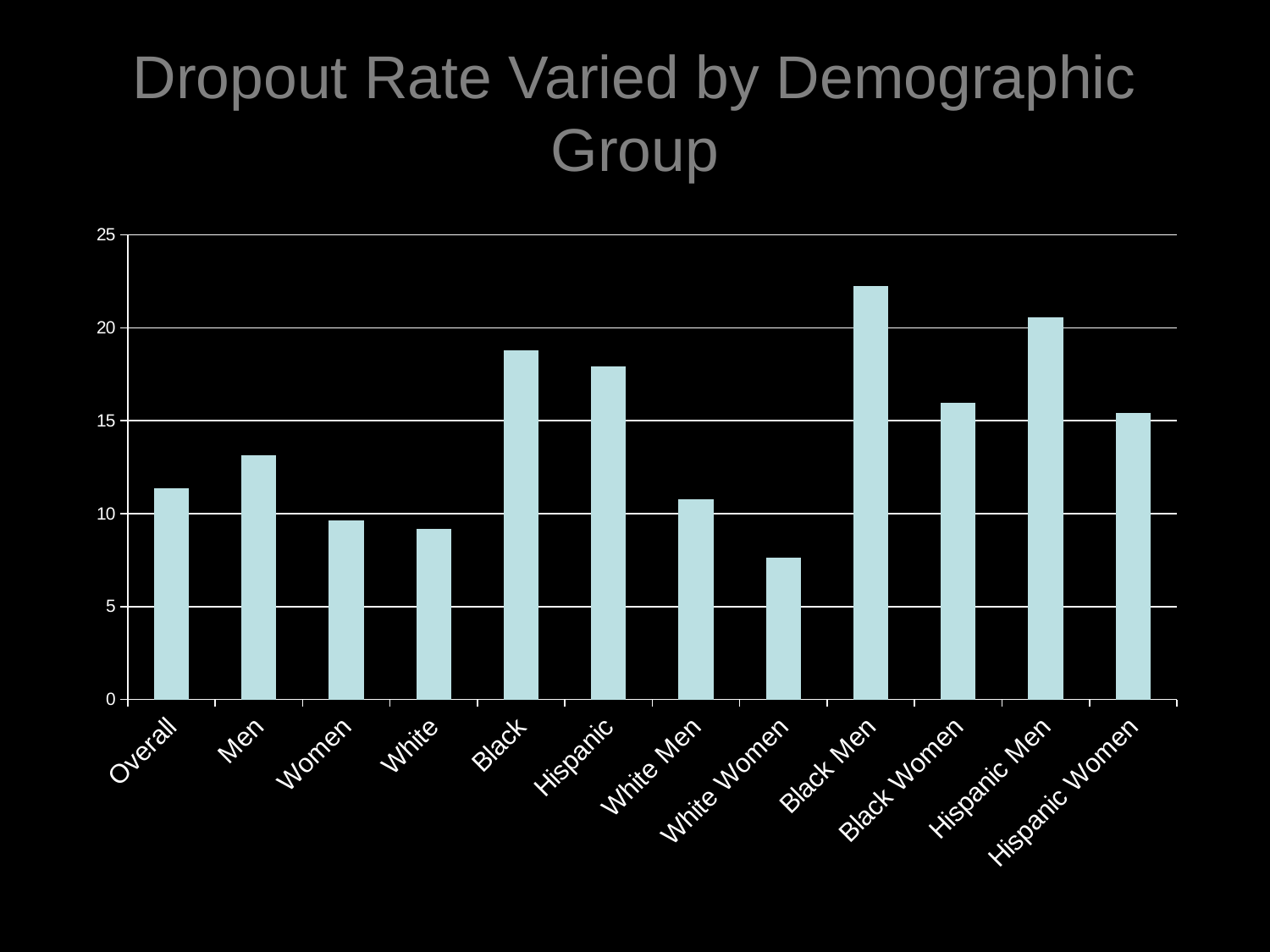
What is the title of the chart on the slide? Dropout Rate Varied by Demographic Group Which demographic group has the highest dropout rate? Black Men Which is larger, the value for Black Men or the value for Hispanic Men? Black Men What kind of chart is shown on the slide? bar chart Is the value for White Women greater or less than 10? less Is the value for Women greater or less than 10? less Which demographic group has the lowest dropout rate? White Women Which is larger, the value for Men or the value for Women? Men Is the value for Black Men greater or less than 20? greater How many demographic groups are plotted on the chart? 12